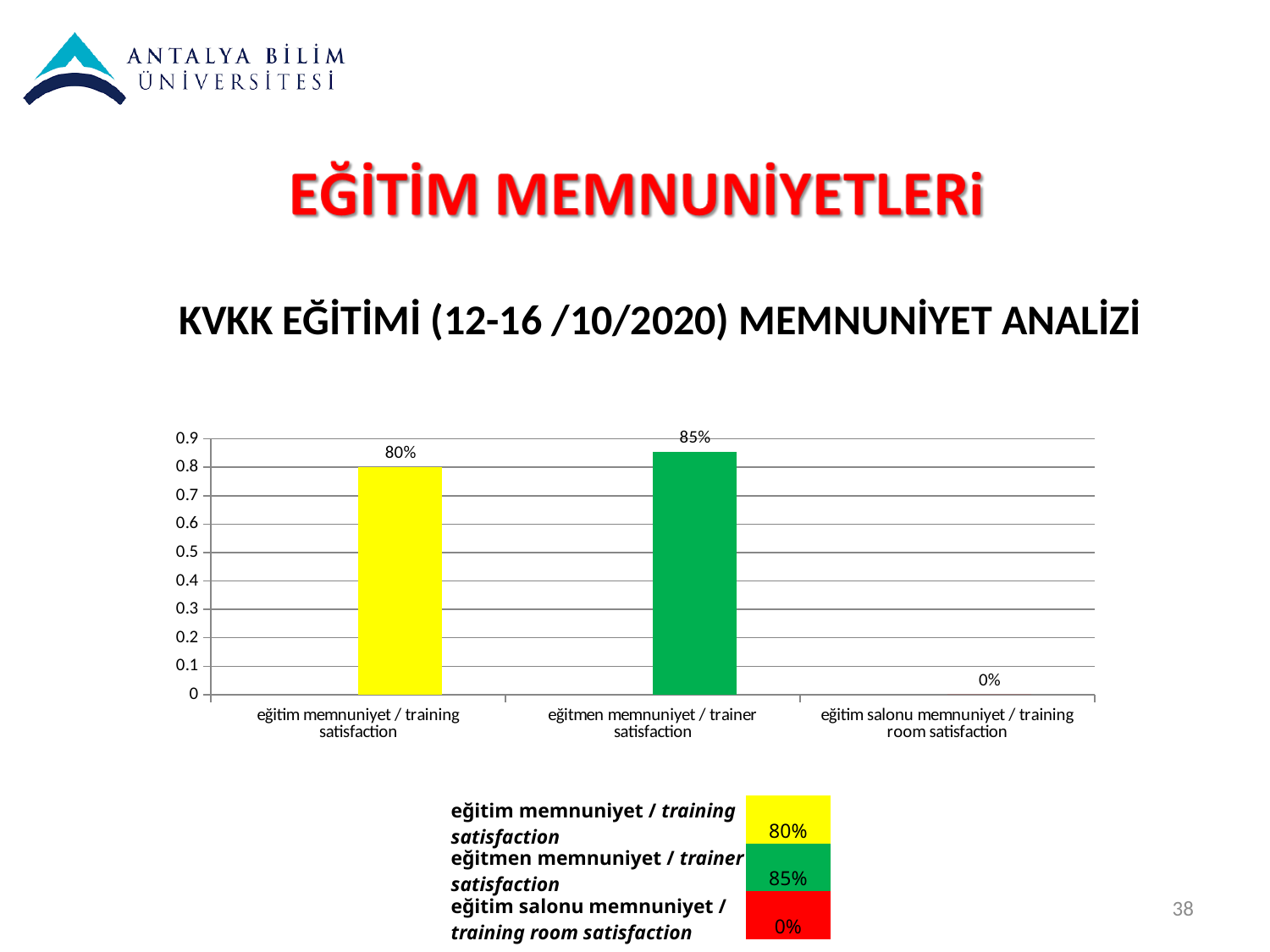
Which is larger, training satisfaction or trainer satisfaction? trainer satisfaction Is the value for training satisfaction greater or less than 0.5? greater What colour is the bar for trainer satisfaction? green Which category has the highest value? eğitmen memnuniyet / trainer satisfaction Which category has the lowest value? eğitim salonu memnuniyet / training room satisfaction What is the value for trainer satisfaction (eğitmen memnuniyet)? 85% What is the highest value shown on the y axis? 0.9 What is the difference between trainer satisfaction and training satisfaction? 5% What kind of chart is shown on the slide? bar chart How many categories are shown on the x axis? 3 What is the value for training satisfaction (eğitim memnuniyet)? 80% What is the value for training room satisfaction (eğitim salonu memnuniyet)? 0%